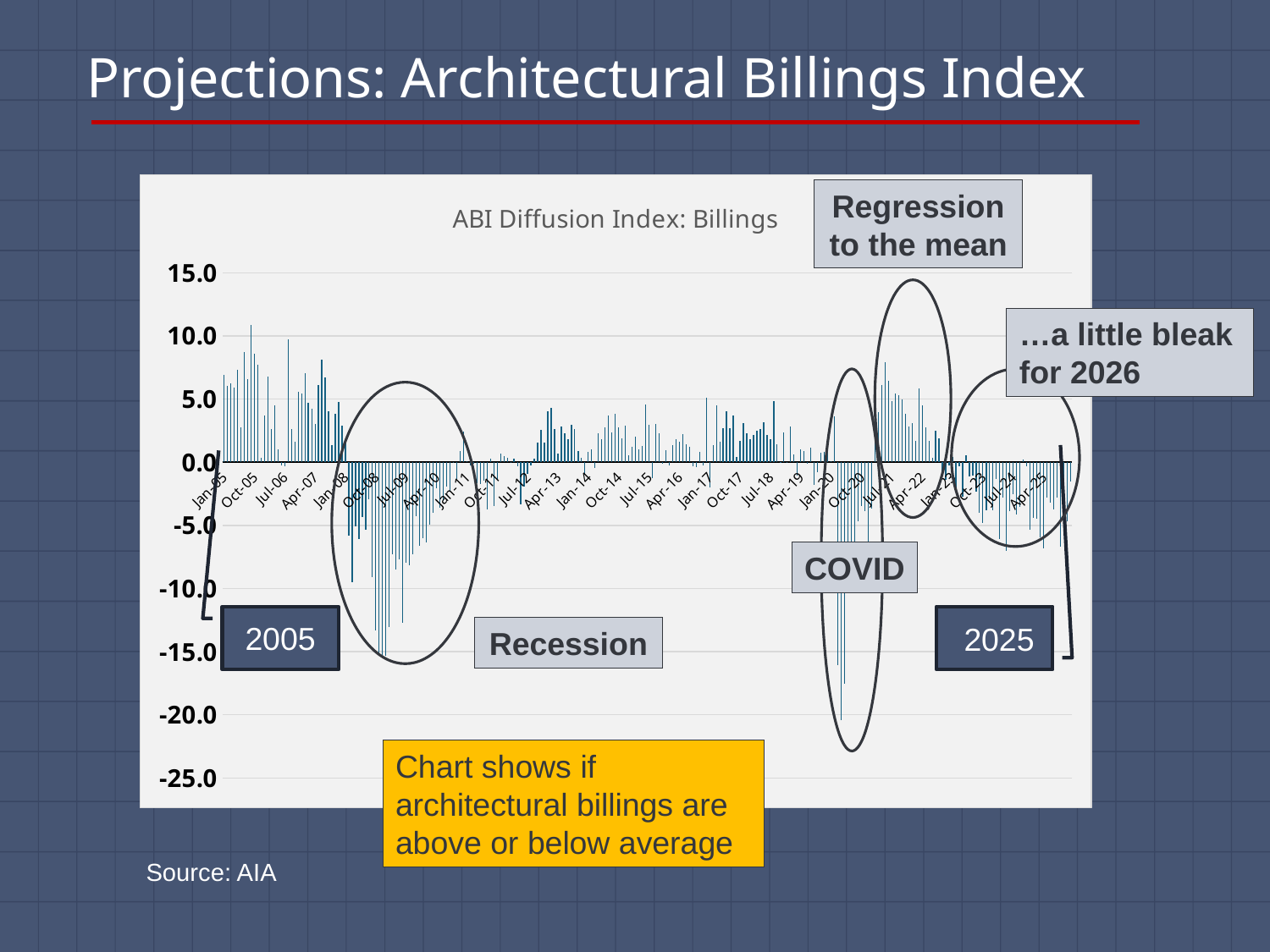
Are the bars around Jul-09 (the Recession period) mostly above or below 0.0? below What is the highest value shown on the chart's vertical axis? 15.0 In which annotated period does the chart reach its lowest value? COVID Are the bars around Apr-25 mostly above or below 0.0? below What is the first date label on the chart's horizontal axis? Jan-05 Is the lowest bar on the chart (in the COVID period) greater or less than -15.0? less What is the title of the chart? ABI Diffusion Index: Billings What is the lowest value shown on the chart's vertical axis? -25.0 What source is cited for the chart? AIA Which is lower, the lowest bar in the Recession period (around 2009) or the lowest bar in the COVID period (around 2020)? COVID period Is the highest bar on the chart greater or less than 15.0? less What kind of chart is shown on the slide? Bar chart